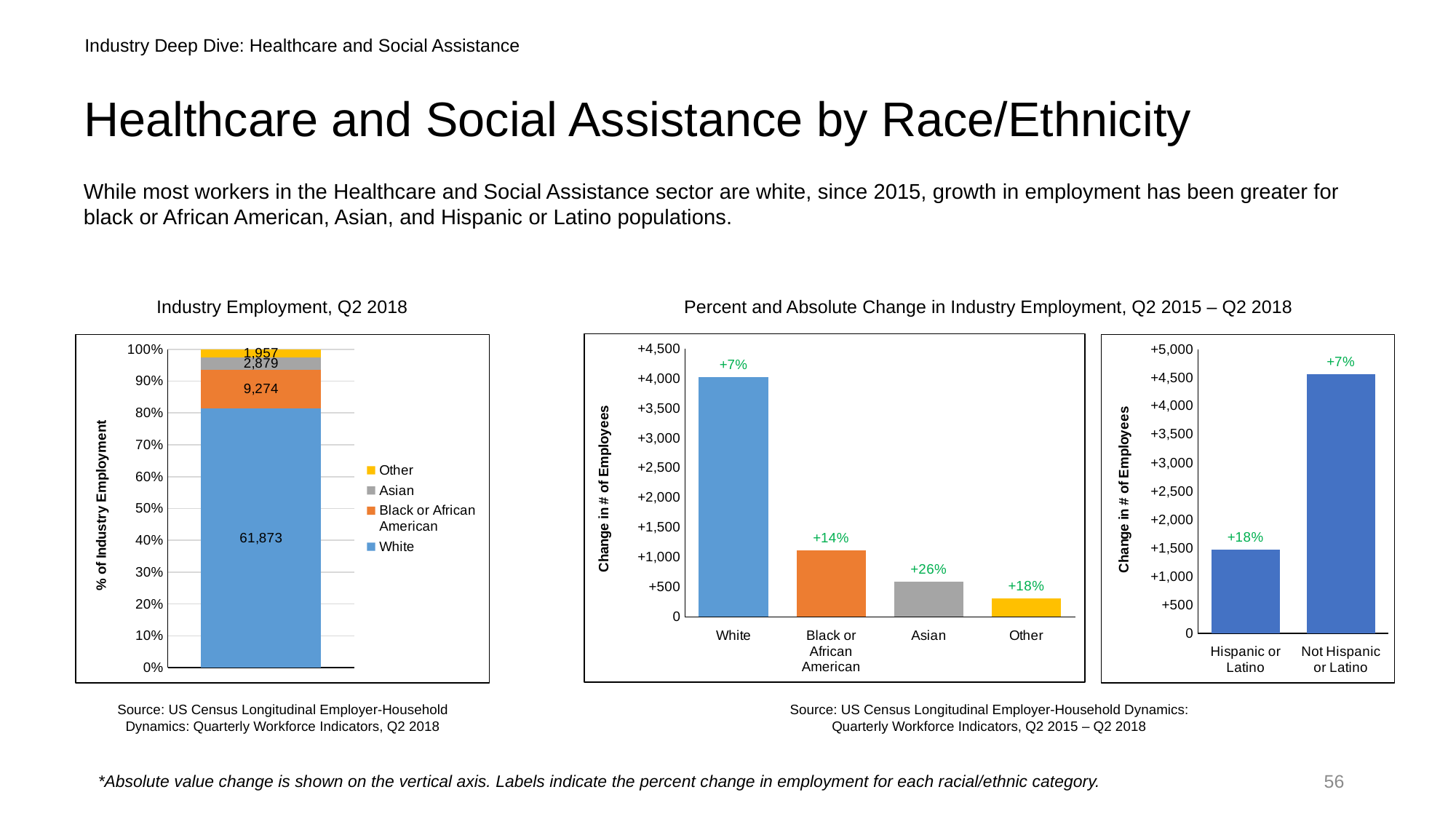
In the middle chart (Percent and Absolute Change in Industry Employment, by race), is the change in number of employees for White greater or less than 3,500? greater In the middle chart (Percent and Absolute Change in Industry Employment, by race), how many categories are shown on the x axis? 4 In the Industry Employment, Q2 2018 chart, what is the value shown for White? 61,873 In the Industry Employment, Q2 2018 chart, how many series does the legend list? 4 In the Industry Employment, Q2 2018 chart, what is the value shown for Black or African American? 9,274 In the rightmost chart (Hispanic or Latino vs Not Hispanic or Latino), what percent change label is shown for Hispanic or Latino? +18% In the middle chart (Percent and Absolute Change in Industry Employment, by race), what percent change label is shown for Asian? +26% In the rightmost chart (Hispanic or Latino vs Not Hispanic or Latino), is the change in number of employees for Not Hispanic or Latino greater or less than 4,000? greater In the Industry Employment, Q2 2018 chart, what is the value shown for Asian? 2,879 In the Industry Employment, Q2 2018 chart, what is the difference between the White and Black or African American values? 52,599 In the Industry Employment, Q2 2018 chart, which series has the smallest value? Other In the middle chart (Percent and Absolute Change in Industry Employment, by race), which category has the largest absolute change in number of employees? White